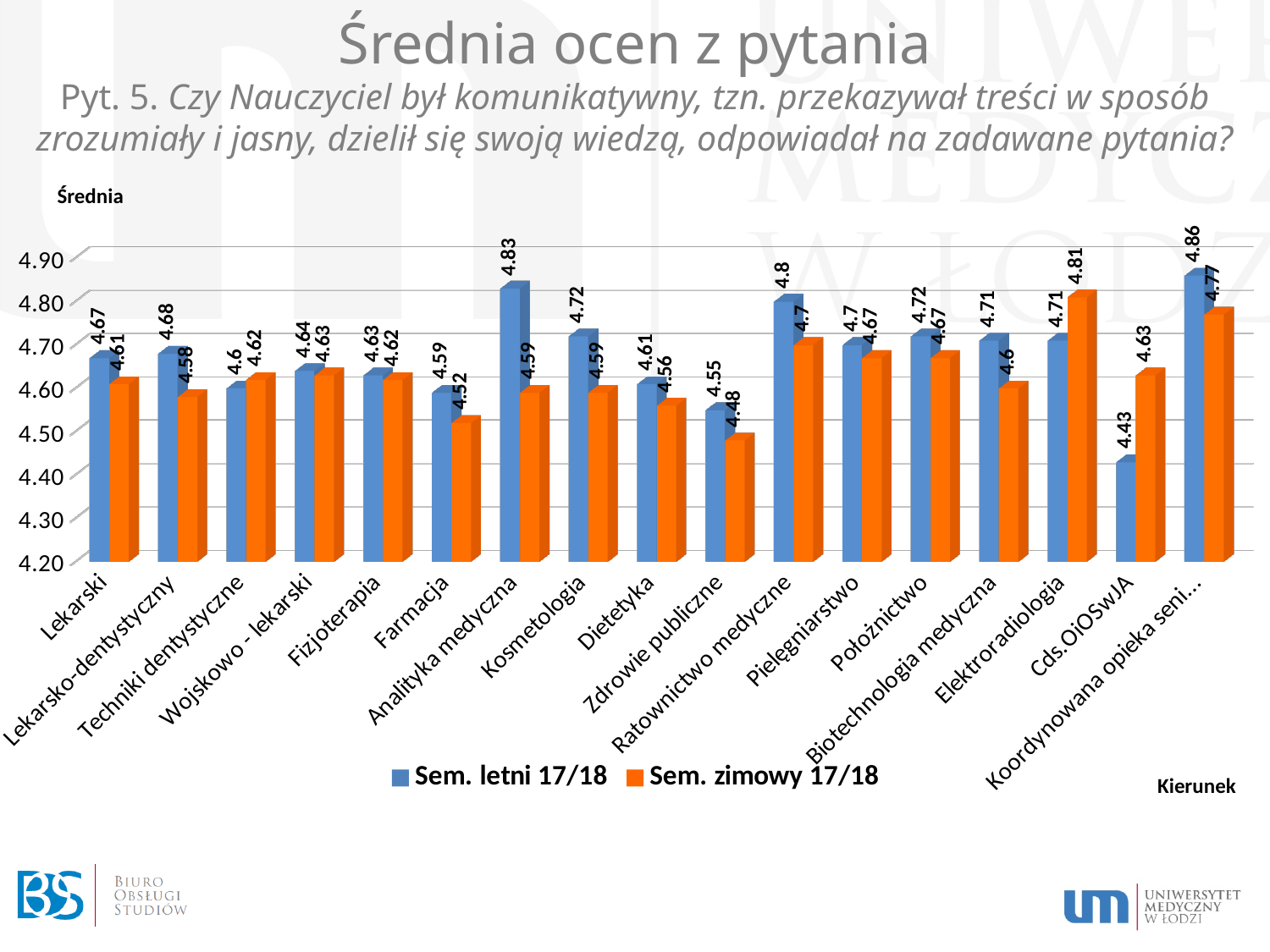
What is the Sem. zimowy 17/18 value for Zdrowie publiczne? 4.48 Which category has the highest Sem. zimowy 17/18 value? Elektroradiologia What is the difference between the Sem. letni 17/18 and Sem. zimowy 17/18 values for Analityka medyczna? 0.24 What is the label of the x axis? Kierunek What type of chart is shown on the slide? bar chart Which is larger: the Sem. letni 17/18 value for Ratownictwo medyczne or for Pielęgniarstwo? Ratownictwo medyczne What is the Sem. letni 17/18 value for Analityka medyczna? 4.83 Which category has the lowest Sem. letni 17/18 value? Cds.OiOSwJA How many series does the legend list? 2 What is the Sem. zimowy 17/18 value for Elektroradiologia? 4.81 Which category has the lowest Sem. zimowy 17/18 value? Zdrowie publiczne Which is larger for Cds.OiOSwJA: the Sem. letni 17/18 value or the Sem. zimowy 17/18 value? Sem. zimowy 17/18